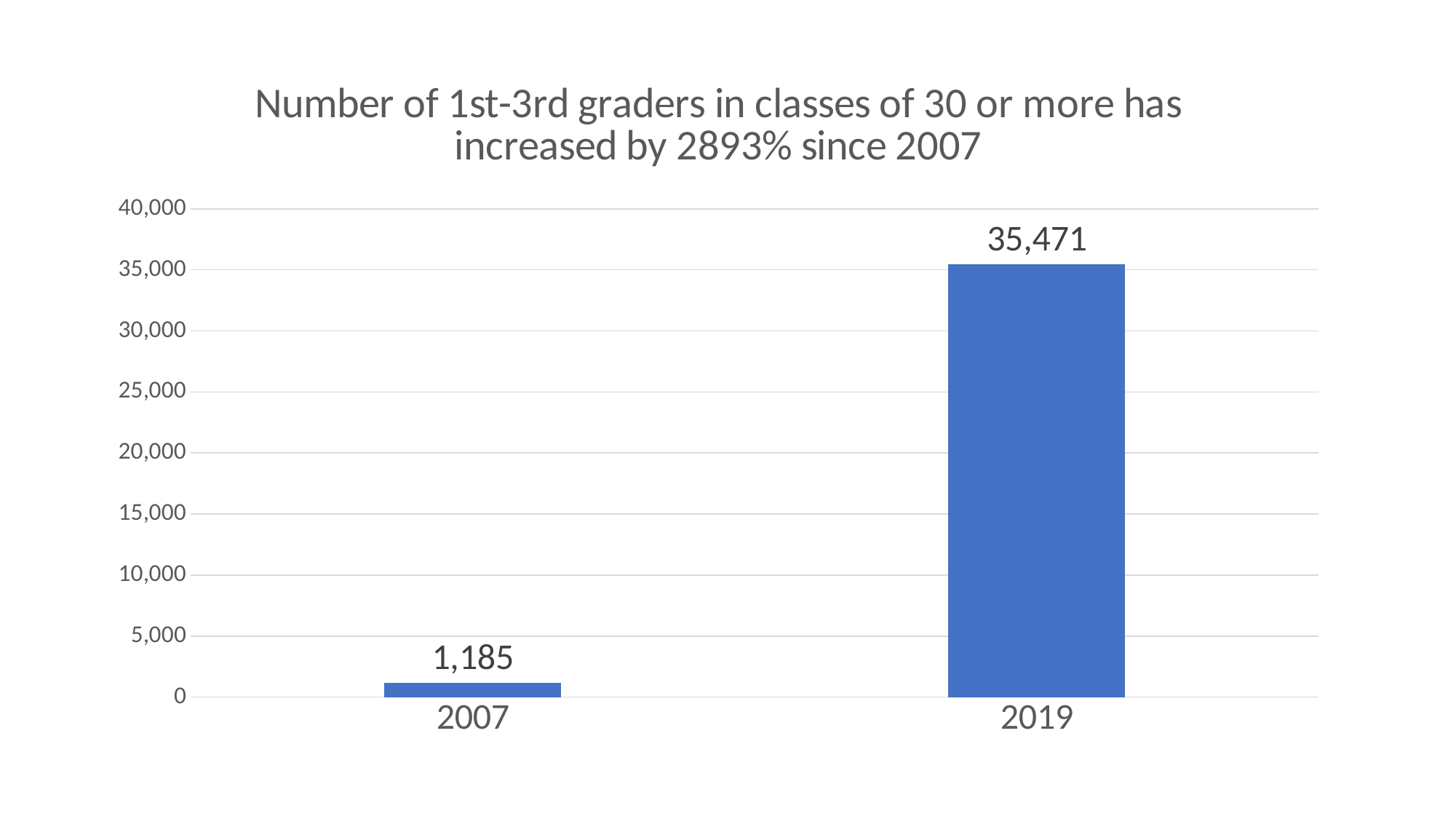
Is the value for 2007 greater or less than 5,000? less What is the value for 2007? 1,185 Which year has the highest value? 2019 How many years are shown on the x axis? 2 Which is larger, the value for 2007 or the value for 2019? 2019 Is the value for 2019 greater or less than 30,000? greater Which year has the lowest value? 2007 By what percentage does the chart title say the number has increased since 2007? 2893% What is the value for 2019? 35,471 What kind of chart is shown on the slide? bar chart What is the difference between the values for 2019 and 2007? 34,286 Do the values rise or fall from 2007 to 2019? rise